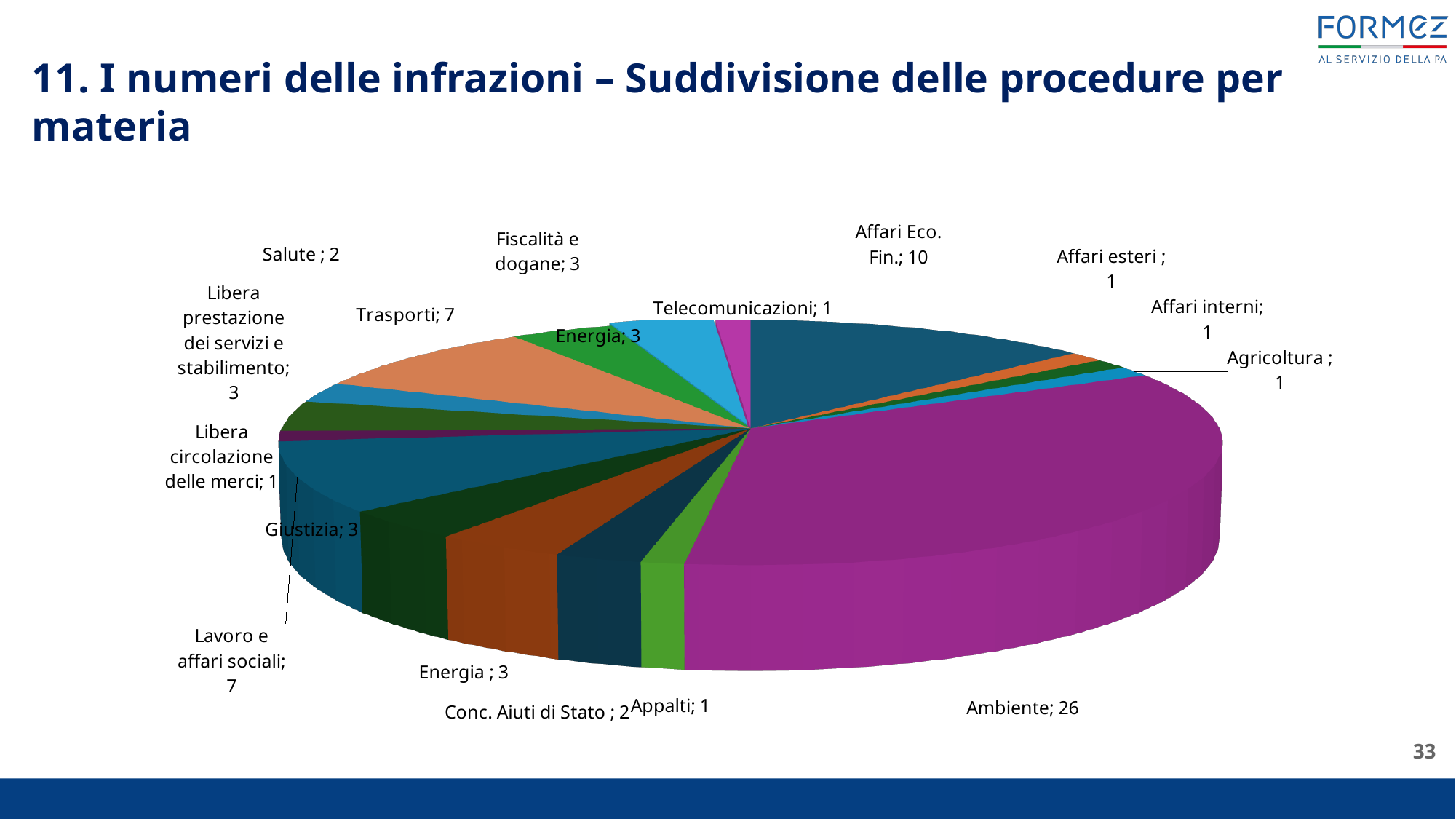
What is the difference between the values for Ambiente and Affari Eco. Fin.? 16 Which category has the largest slice of the pie? Ambiente What is the value for Ambiente? 26 What is the value for Conc. Aiuti di Stato? 2 What is the value for Affari Eco. Fin.? 10 What is the title of the slide containing the chart? 11. I numeri delle infrazioni – Suddivisione delle procedure per materia What is the value for Lavoro e affari sociali? 7 What is the value for Fiscalità e dogane? 3 Which is larger, the value for Trasporti or the value for Giustizia? Trasporti What is the value for Trasporti? 7 What kind of chart is shown on the slide? pie chart How many slices does the pie chart have? 17